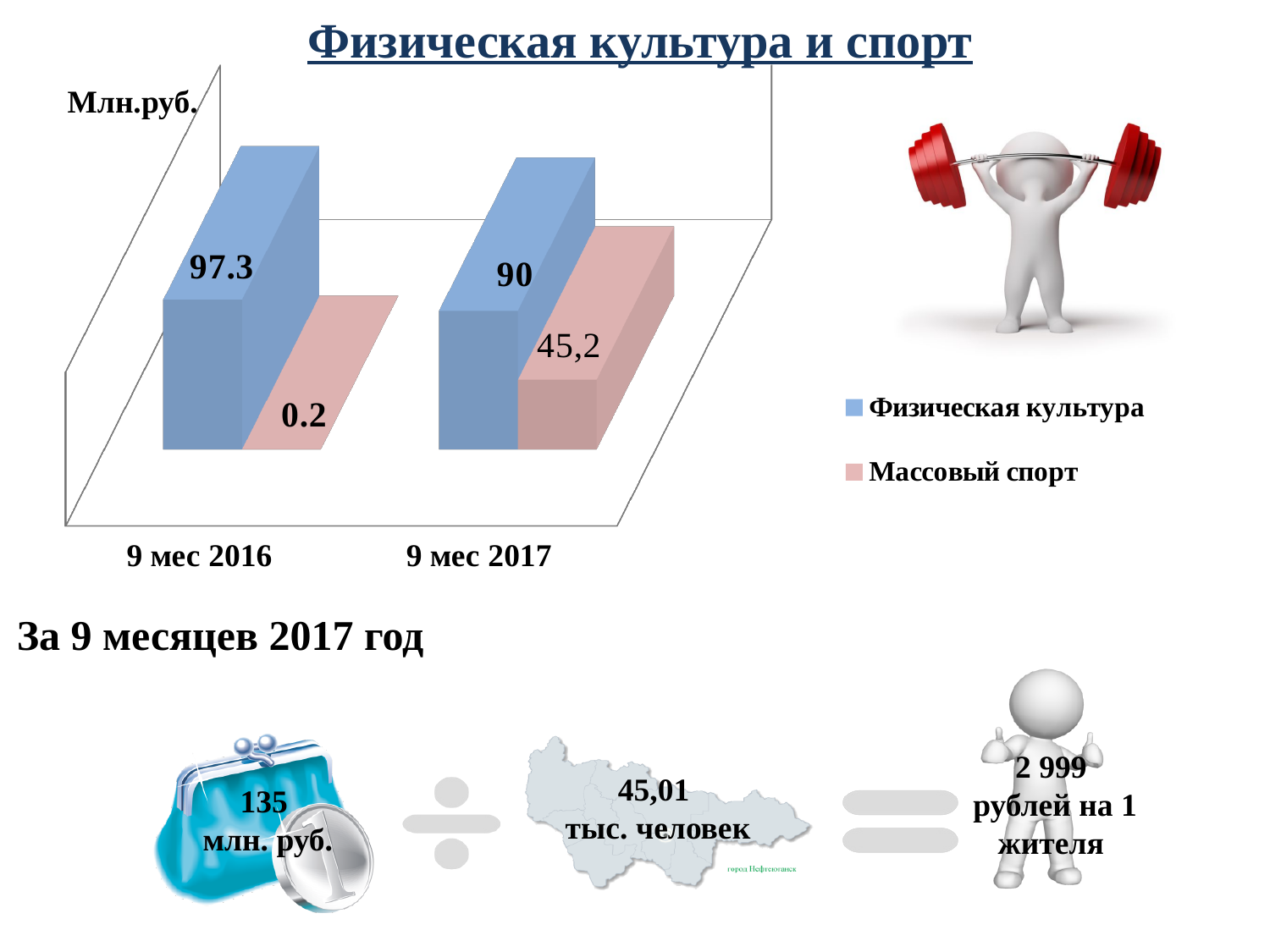
What is the value for Массовый спорт for 9 мес 2017? 45,2 How many categories are shown on the x axis? 2 What type of chart is shown on the slide? bar chart Which bar has the lowest value in the chart? Массовый спорт, 9 мес 2016 How many series does the legend list? 2 What unit is shown on the chart's axis label? Млн.руб. What is the value for Массовый спорт for 9 мес 2016? 0.2 What is the value for Физическая культура for 9 мес 2016? 97.3 What is the value for Физическая культура for 9 мес 2017? 90 Which series has the highest value in the chart? Физическая культура Does the value for Физическая культура rise or fall from 9 мес 2016 to 9 мес 2017? fall What is the difference between Физическая культура for 9 мес 2016 and 9 мес 2017? 7.3